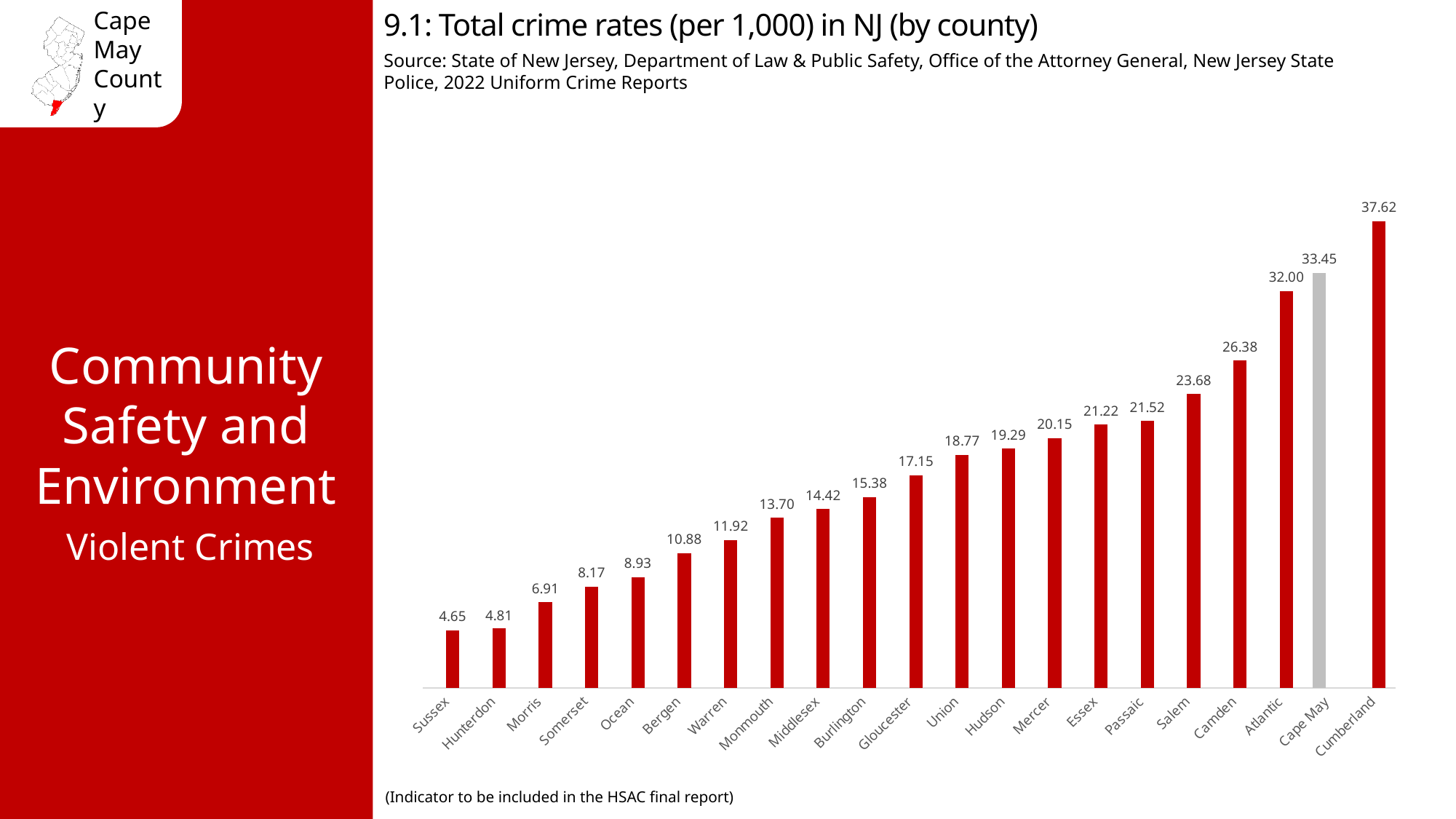
What is the total crime rate per 1,000 for Bergen County? 10.88 Which county has the highest total crime rate? Cumberland What is the difference between the crime rates of Cumberland and Cape May? 4.17 How many counties are shown in the chart? 21 Which has a higher total crime rate, Atlantic or Camden? Atlantic Which county's bar is coloured grey instead of red? Cape May Which county has the lowest total crime rate? Sussex What is the total crime rate per 1,000 for Hudson County? 19.29 What is the total crime rate per 1,000 for Cape May County? 33.45 Do the crime rates rise or fall moving from left to right along the x axis? Rise What kind of chart is shown on the slide? Bar chart What is the difference between the crime rates of Camden and Salem? 2.70